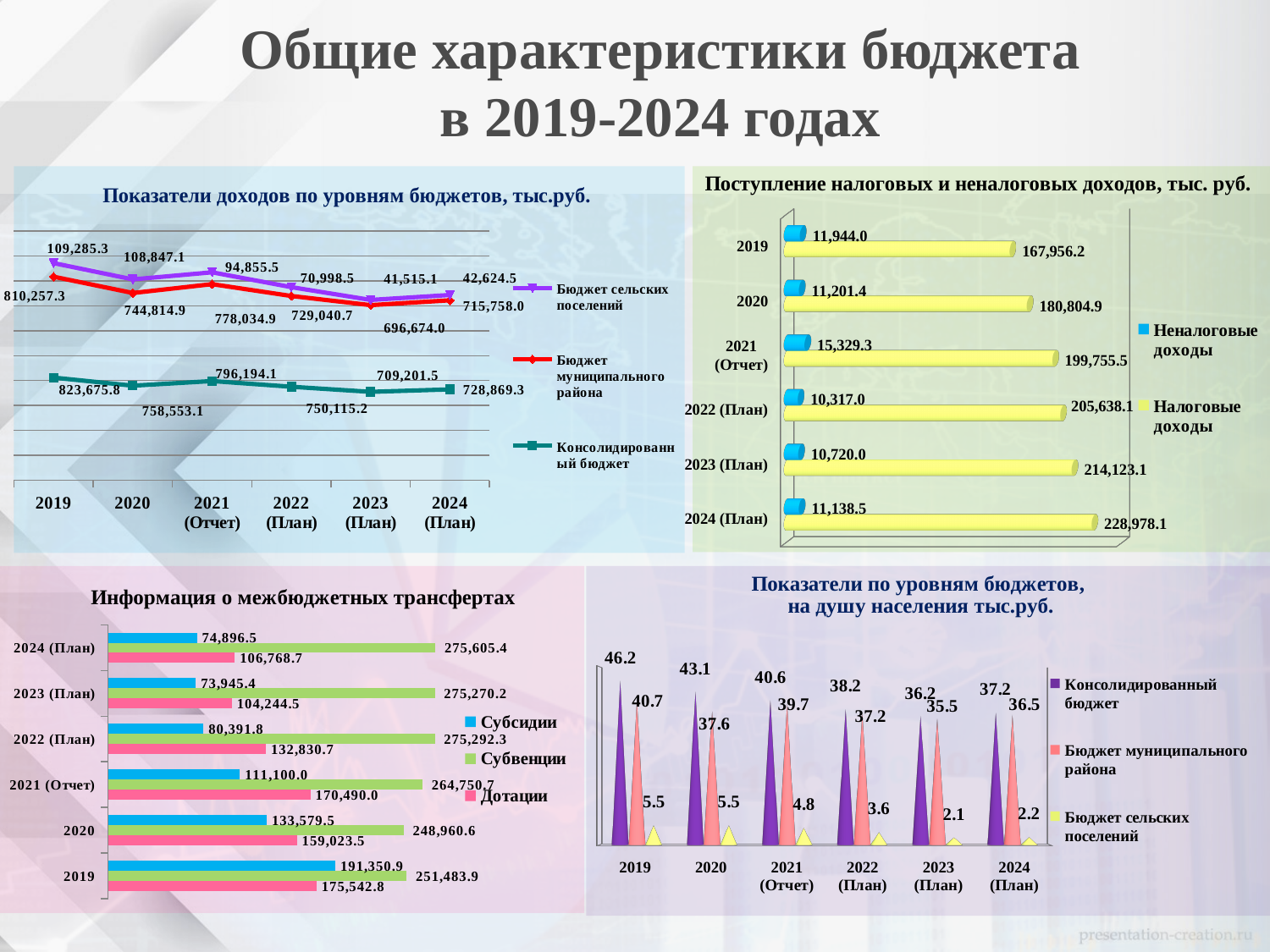
In the chart 'Показатели доходов по уровням бюджетов, тыс.руб.', how many series does the legend list? 3 In the chart 'Информация о межбюджетных трансфертах', what kind of chart is shown? bar chart In the chart 'Поступление налоговых и неналоговых доходов, тыс. руб.', what is the value of Налоговые доходы for 2024 (План)? 228,978.1 In the chart 'Поступление налоговых и неналоговых доходов, тыс. руб.', do the Налоговые доходы values rise or fall from 2019 to 2024 (План)? rise In the chart 'Показатели доходов по уровням бюджетов, тыс.руб.', which year has the lowest value for Бюджет сельских поселений? 2023 (План) In the chart 'Поступление налоговых и неналоговых доходов, тыс. руб.', which year has the highest value of Неналоговые доходы? 2021 (Отчет) In the chart 'Информация о межбюджетных трансфертах', which year has the highest value of Субсидии? 2019 In the chart 'Показатели доходов по уровням бюджетов, тыс.руб.', what is the value of Консолидированный бюджет for 2019? 823,675.8 In the chart 'Информация о межбюджетных трансфертах', what is the value of Дотации for 2021 (Отчет)? 170,490.0 In the chart 'Показатели по уровням бюджетов, на душу населения тыс.руб.', what is the difference between Консолидированный бюджет and Бюджет муниципального района in 2020? 5.5 In the chart 'Показатели по уровням бюджетов, на душу населения тыс.руб.', how many years are shown on the x axis? 6 In the chart 'Показатели по уровням бюджетов, на душу населения тыс.руб.', what is the value of Консолидированный бюджет for 2019? 46.2